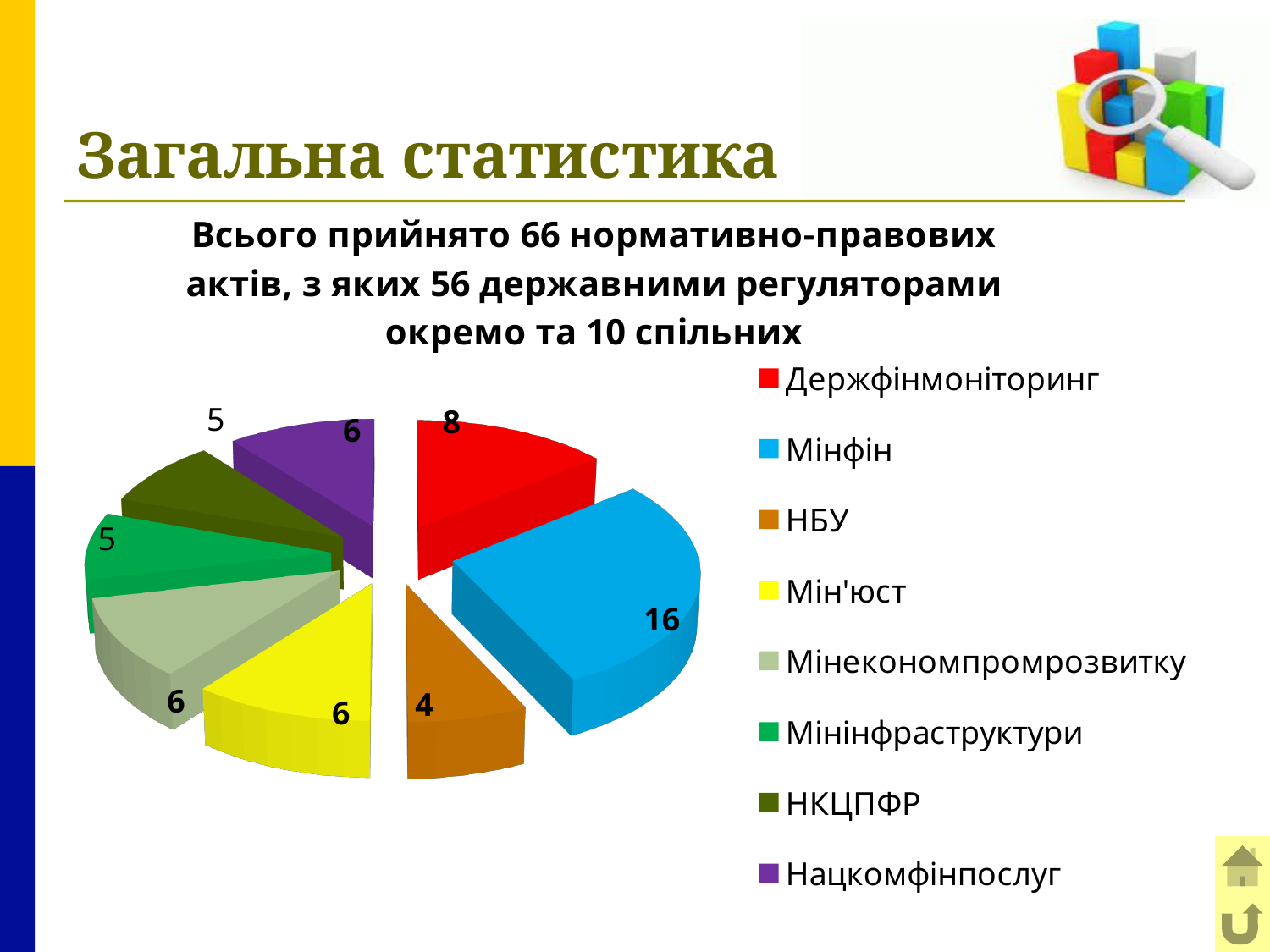
Which category has the largest slice of the pie? Мінфін Which is larger, the value for Мін'юст or the value for НКЦПФР? Мін'юст Which category has the smallest slice of the pie? НБУ What is the difference between the values for Мінфін and Держфінмоніторинг? 8 What type of chart is shown on the slide? pie chart What is the value for Держфінмоніторинг? 8 What is the value for Мінфін? 16 How many slices does the pie chart have? 8 What is the value for НБУ? 4 What is the value for Мінінфраструктури? 5 What colour is the slice for Нацкомфінпослуг? purple What is the sum of all the values shown on the pie chart? 56